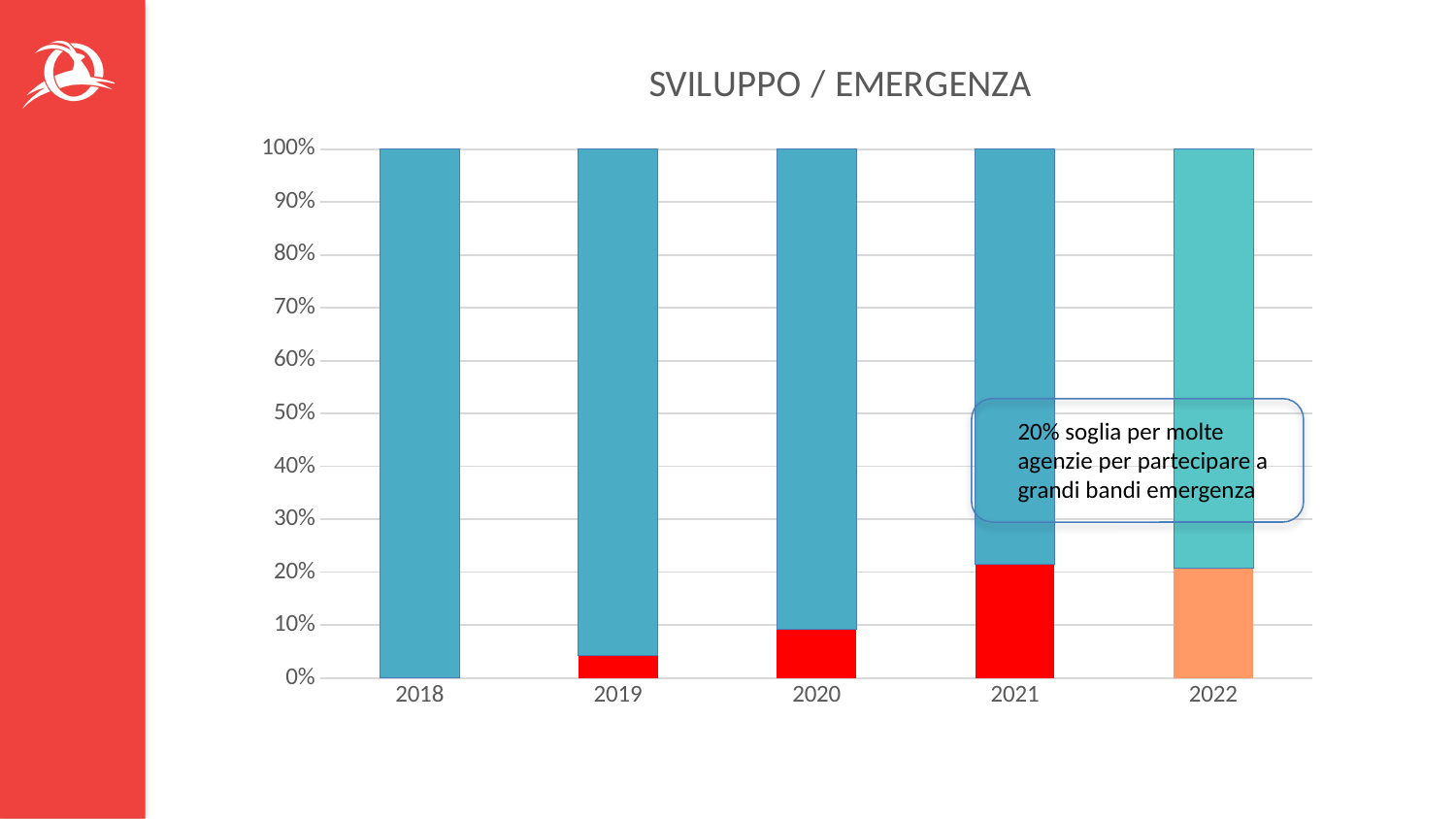
Does the bottom (red/orange) segment rise or fall from 2018 to 2021? rise Which year has no red (bottom) segment in its bar? 2018 What is the first year shown on the x axis? 2018 What is the total height of each stacked bar in the chart? 100% Is the red bottom segment for 2019 greater or less than 10%? less Which year has the larger red bottom segment, 2019 or 2020? 2020 Is the red bottom segment for 2020 greater or less than 20%? less How many years are shown on the x axis of the chart? 5 Is the red bottom segment for 2021 greater or less than 10%? greater What is the title of the chart? SVILUPPO / EMERGENZA What is the last year shown on the x axis? 2022 What kind of chart is shown on the slide? Stacked bar chart